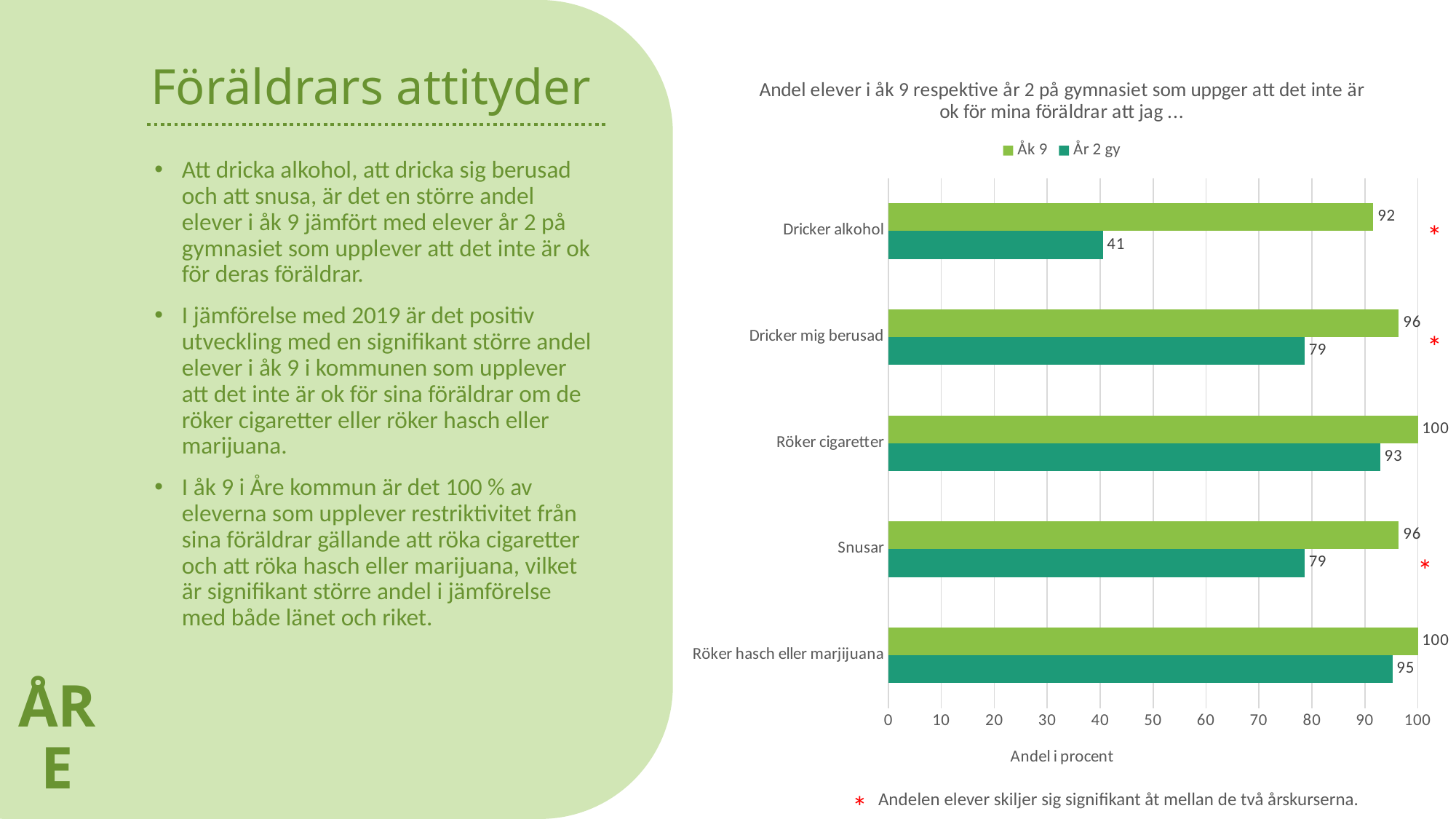
Which is larger for Dricker mig berusad: the Åk 9 value or the År 2 gy value? Åk 9 What is the value for År 2 gy for Dricker alkohol? 41 What kind of chart is shown on the slide? Bar chart What is the value for Åk 9 for Snusar? 96 What is the difference between the Åk 9 and År 2 gy values for Röker hasch eller marjijuana? 5 What is the value for År 2 gy for Röker cigaretter? 93 Which category has the lowest value for År 2 gy? Dricker alkohol What is the value for Åk 9 for Dricker alkohol? 92 How many categories are shown on the chart? 5 What is the difference between the Åk 9 and År 2 gy values for Dricker alkohol? 51 What is the x-axis title of the chart? Andel i procent How many series does the legend list? 2